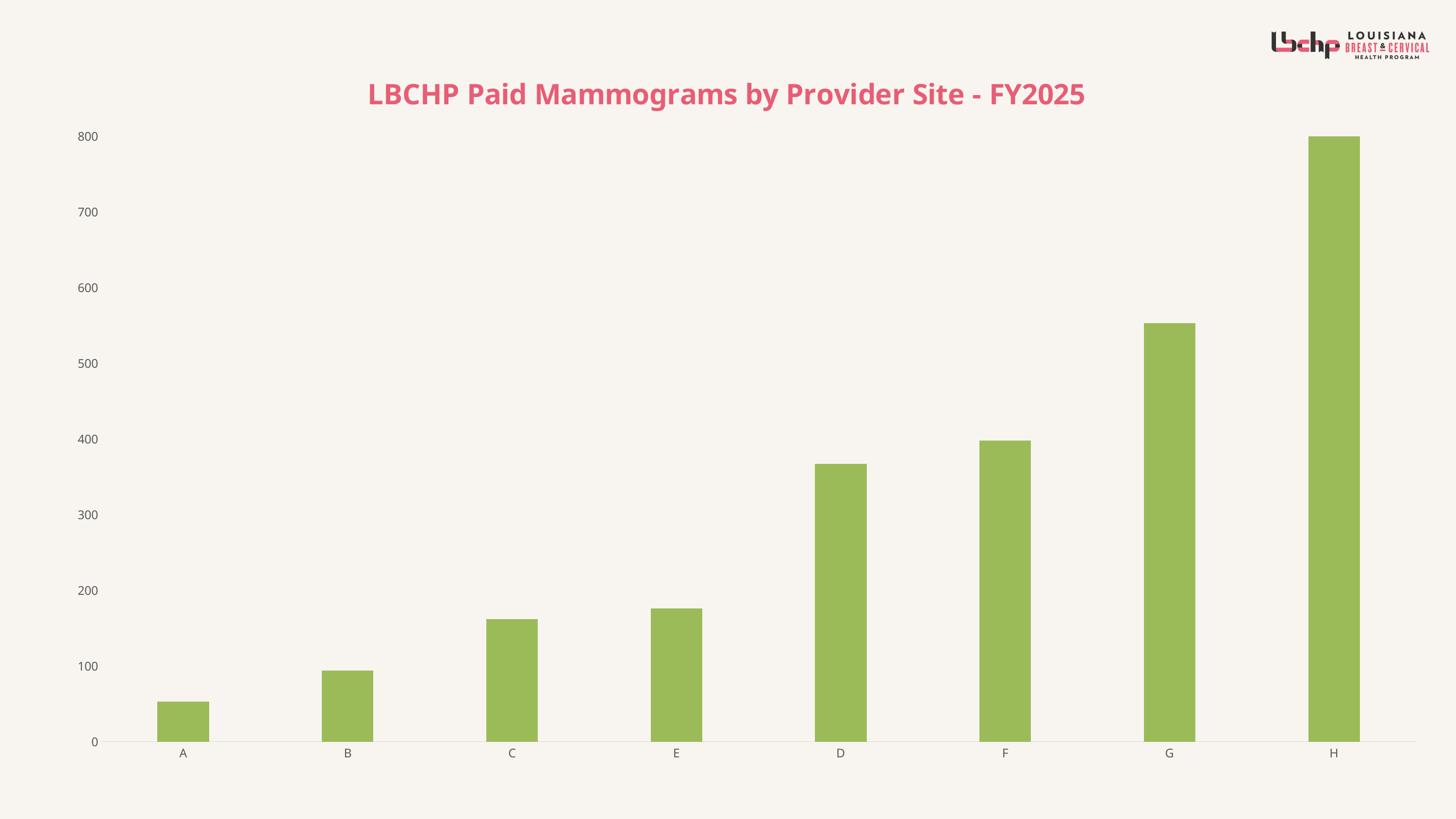
Is the value for provider site C greater or less than 200? less Is the value for provider site A greater or less than 100? less Which provider site has more paid mammograms, G or D? G Do the values generally rise or fall moving from left to right along the x axis? rise Which provider site has the highest number of paid mammograms? H What is the title of the chart? LBCHP Paid Mammograms by Provider Site - FY2025 Is the value for provider site D greater or less than 300? greater Which provider site has the lowest number of paid mammograms? A What kind of chart is shown on the slide? bar chart How many provider sites are shown on the x axis? 8 Which provider site has more paid mammograms, F or E? F